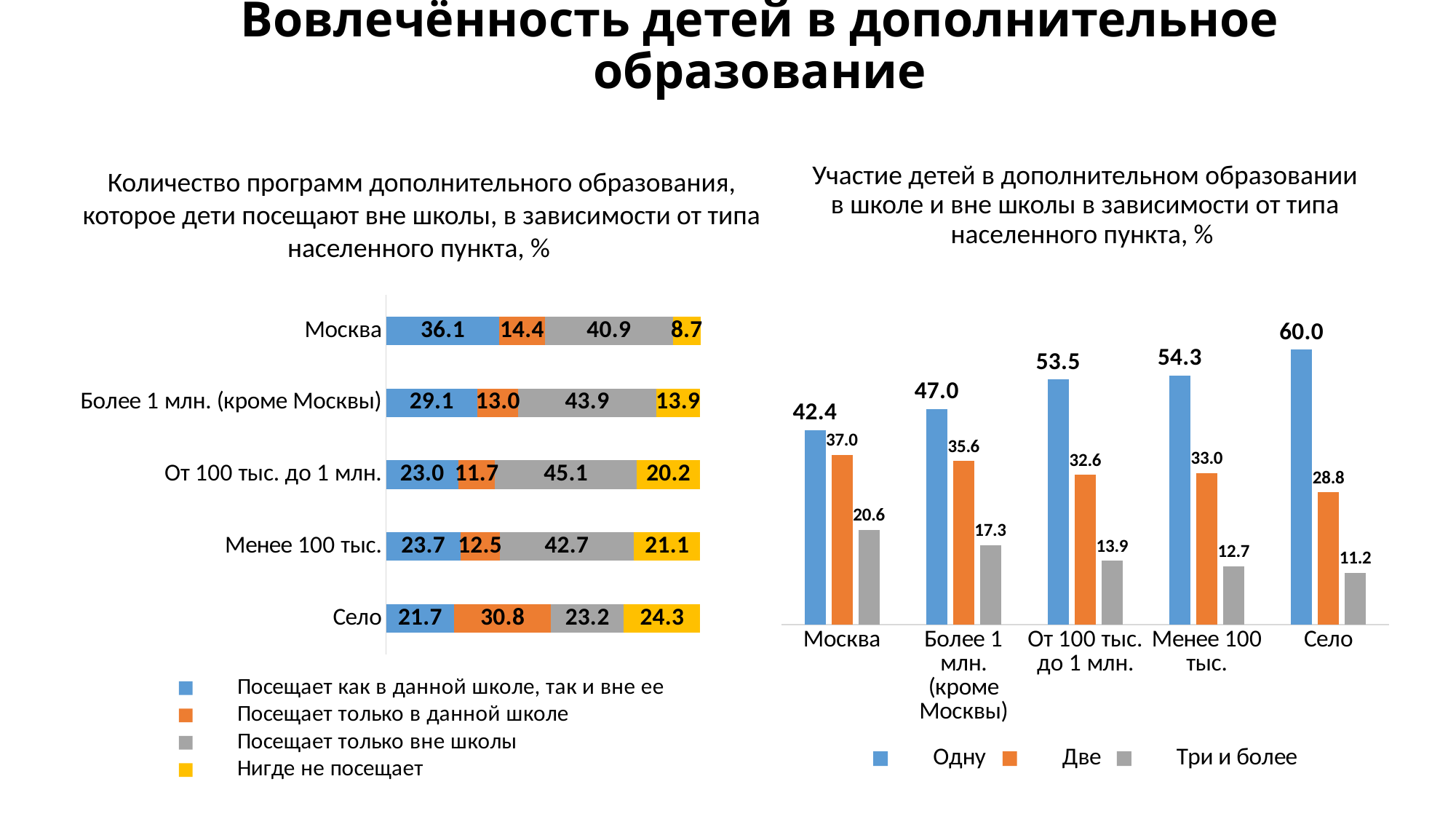
In the right chart, what is the difference between the 'Одну' values for Село and Москва? 17.6 In the right chart, do the values for 'Одну' rise or fall from Москва to Село? Rise What kind of chart is the left chart? Stacked bar chart In the left chart, what is the value for Село in the series 'Нигде не посещает'? 24.3 In the right chart, which category has the lowest value for 'Три и более'? Село In the left chart, what is the difference between the 'Посещает только в данной школе' values for Село and Москва? 16.4 In the right chart, which is larger for the series 'Две': Москва or Село? Москва In the left chart, which category has the highest value for 'Посещает только вне школы'? От 100 тыс. до 1 млн. In the left chart, what is the total of the stacked bar for Москва? 100.1 In the left chart, what is the value for Москва in the series 'Посещает как в данной школе, так и вне ее'? 36.1 In the right chart, what is the value for Село in the series 'Одну'? 60.0 In the left chart, how many series does the legend list? 4